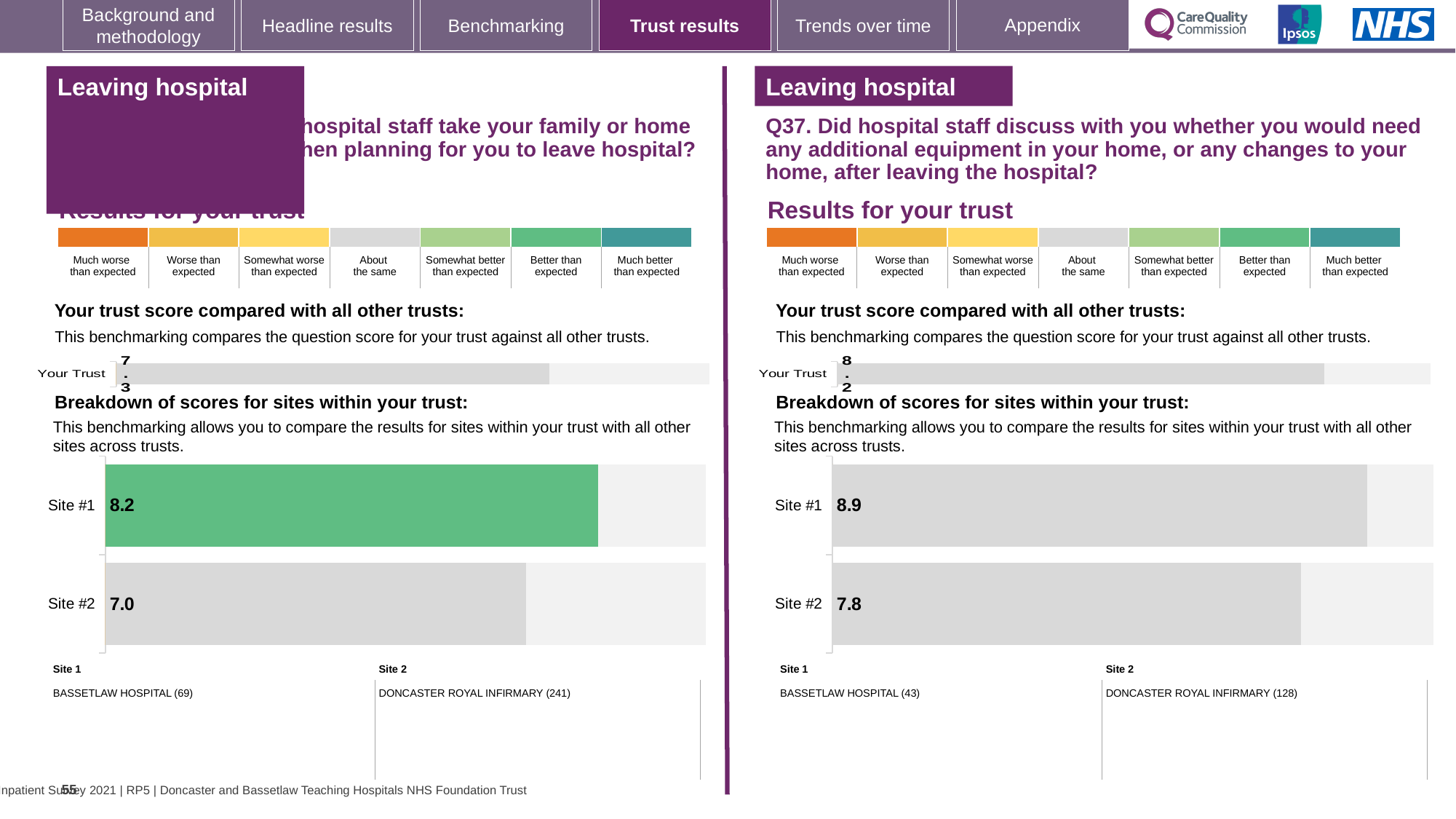
In the site breakdown chart on the left-hand side of the slide, which site has the lower score? Site #2 How many sites are shown in the site breakdown chart on the right-hand side of the slide (Q37)? 2 In the site breakdown chart on the left-hand side of the slide, what is the score for Site #2? 7.0 In the site breakdown chart on the right-hand side of the slide (Q37), which site has the higher score? Site #1 In the site breakdown chart on the left-hand side of the slide, what is the difference between the Site #1 and Site #2 scores? 1.2 In the 'Your Trust' bar on the right-hand side of the slide (Q37), what is the trust score? 8.2 In the site breakdown chart on the right-hand side of the slide (Q37), what is the score for Site #2? 7.8 In the 'Your Trust' bar on the left-hand side of the slide, what is the trust score? 7.3 In the site breakdown chart on the right-hand side of the slide (Q37), what is the difference between the Site #1 and Site #2 scores? 1.1 What type of chart is used for the site breakdown on the left-hand side of the slide? Bar chart In the site breakdown chart on the right-hand side of the slide (Q37), what is the score for Site #1? 8.9 In the site breakdown chart on the left-hand side of the slide, what is the score for Site #1? 8.2